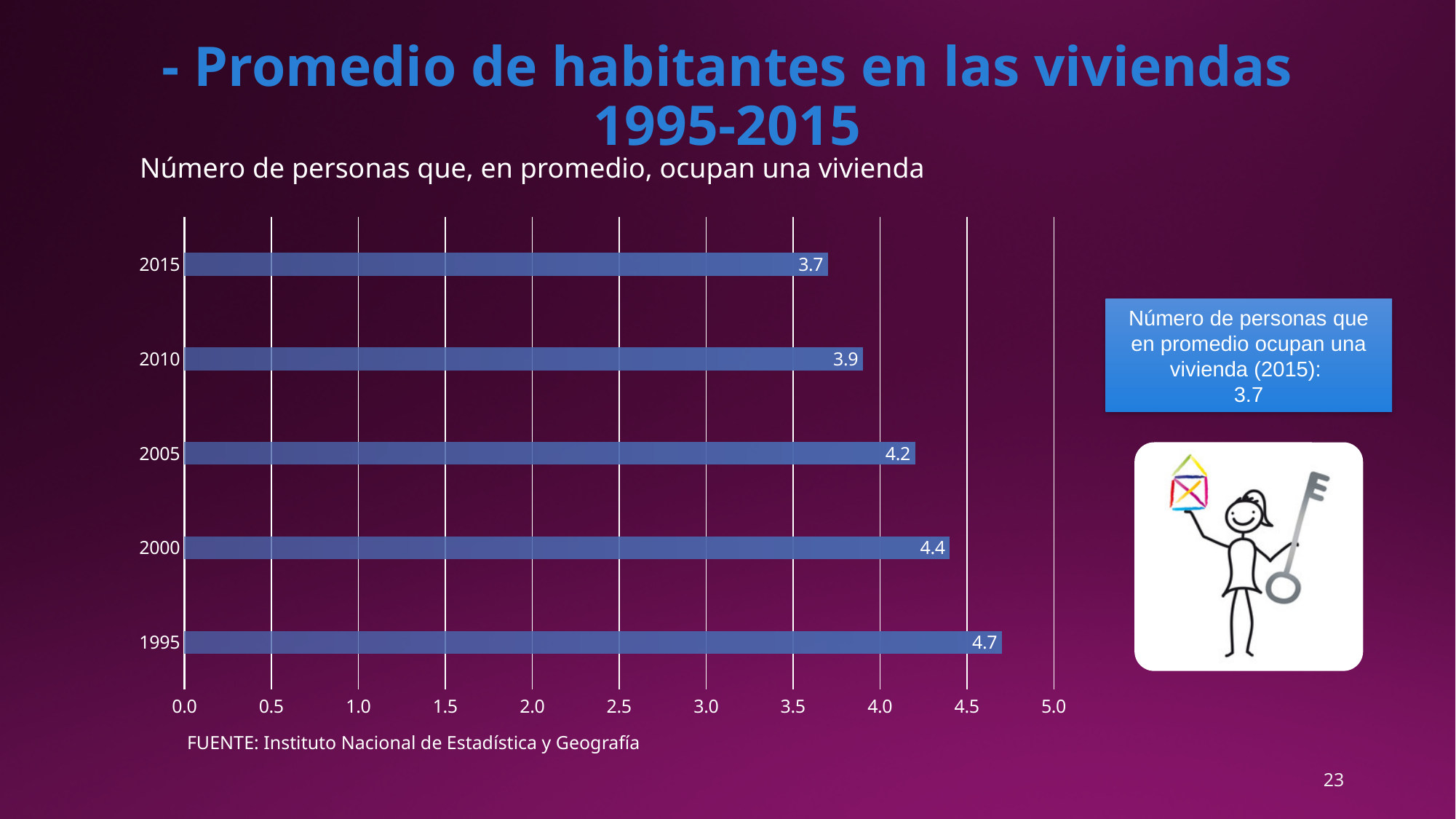
Do the values rise or fall from 1995 to 2015? fall What kind of chart is shown on the slide? bar chart What is the value shown for 2000? 4.4 How many years are shown in the chart? 5 Which year has the lowest average number of people per dwelling? 2015 What is the difference between the values for 2010 and 2005? 0.3 What is the value shown for 2005? 4.2 What is the average number of people per dwelling in 2015? 3.7 Which year has the highest average number of people per dwelling? 1995 Is the value for 2010 greater or less than 4.0? less Which is larger, the value for 2000 or the value for 2010? 2000 What is the difference between the values for 1995 and 2015? 1.0